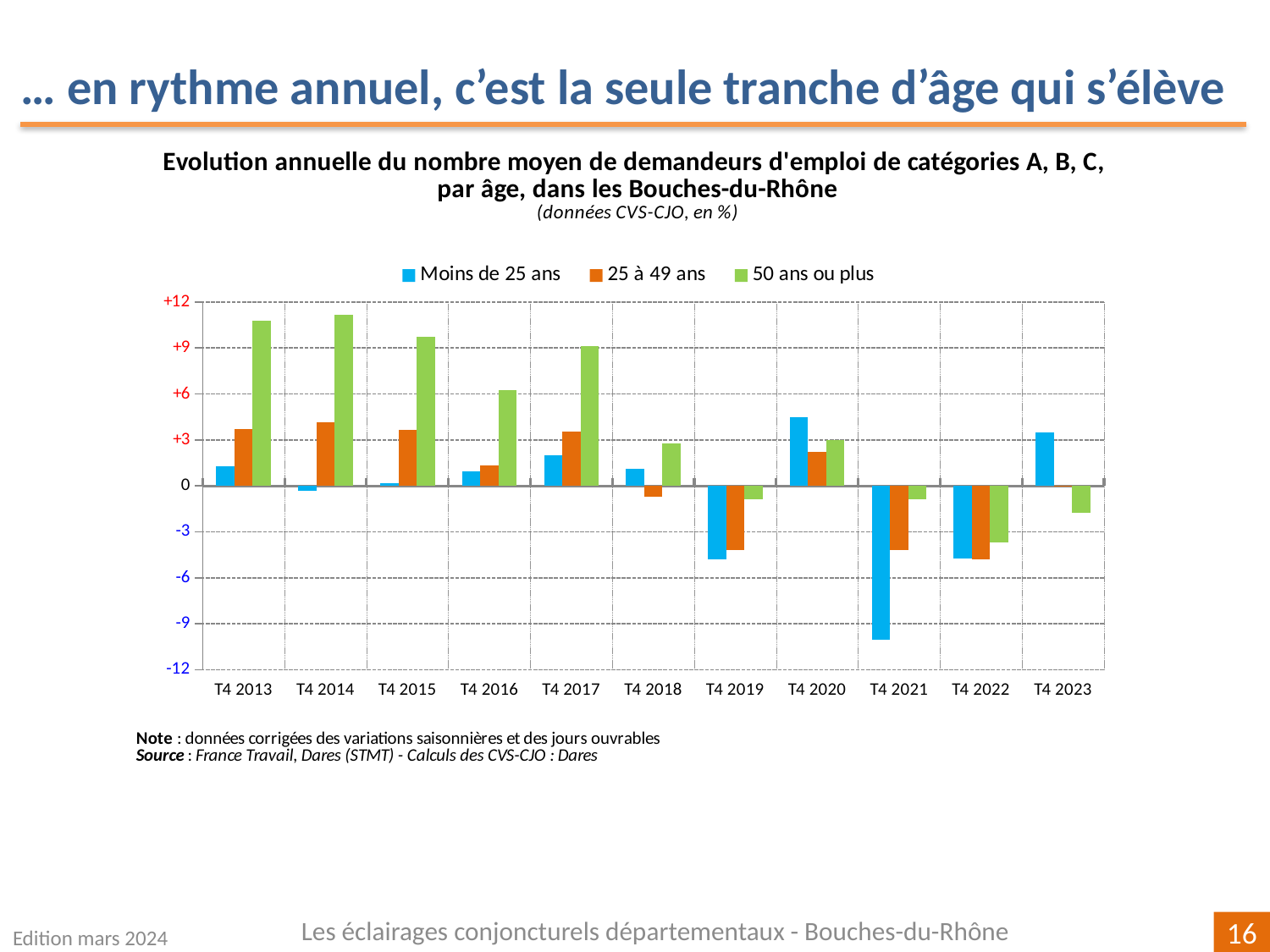
Is the value for '50 ans ou plus' in T4 2022 greater or less than -3? less Is the value for '50 ans ou plus' in T4 2013 greater or less than +9? greater What colour represents the '50 ans ou plus' series in the legend? green Is the value for '25 à 49 ans' in T4 2014 greater or less than +3? greater How many series does the legend list? 3 What kind of chart is shown on the slide? bar chart How many quarters are shown on the x axis? 11 Which series has the highest value in T4 2017? 50 ans ou plus In T4 2023, which is larger: the value for 'Moins de 25 ans' or for '50 ans ou plus'? Moins de 25 ans In which quarter is the value for 'Moins de 25 ans' the lowest? T4 2021 In T4 2020, which is larger: the value for 'Moins de 25 ans' or for '25 à 49 ans'? Moins de 25 ans